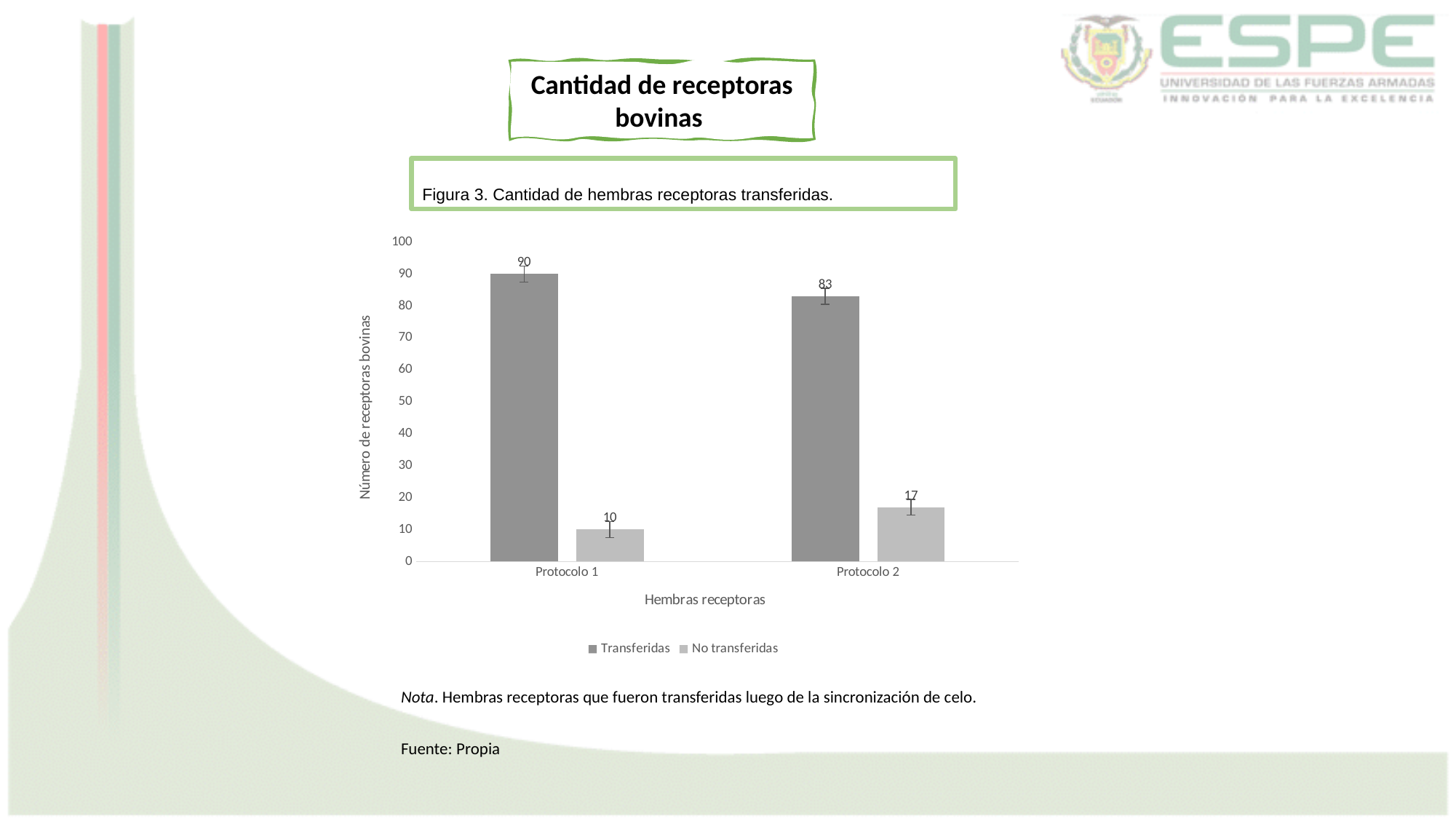
What is the value for Transferidas in Protocolo 1? 90 What is the label of the y axis? Número de receptoras bovinas Which protocol has the highest value for Transferidas? Protocolo 1 What is the value for Transferidas in Protocolo 2? 83 Which protocol has the lowest value for No transferidas? Protocolo 1 How many series does the legend list? 2 What kind of chart is shown on the slide? Bar chart What is the value for No transferidas in Protocolo 1? 10 What is the difference between Transferidas and No transferidas in Protocolo 2? 66 Which is larger: No transferidas in Protocolo 1 or No transferidas in Protocolo 2? Protocolo 2 What is the value for No transferidas in Protocolo 2? 17 What is the difference between Transferidas in Protocolo 1 and Protocolo 2? 7